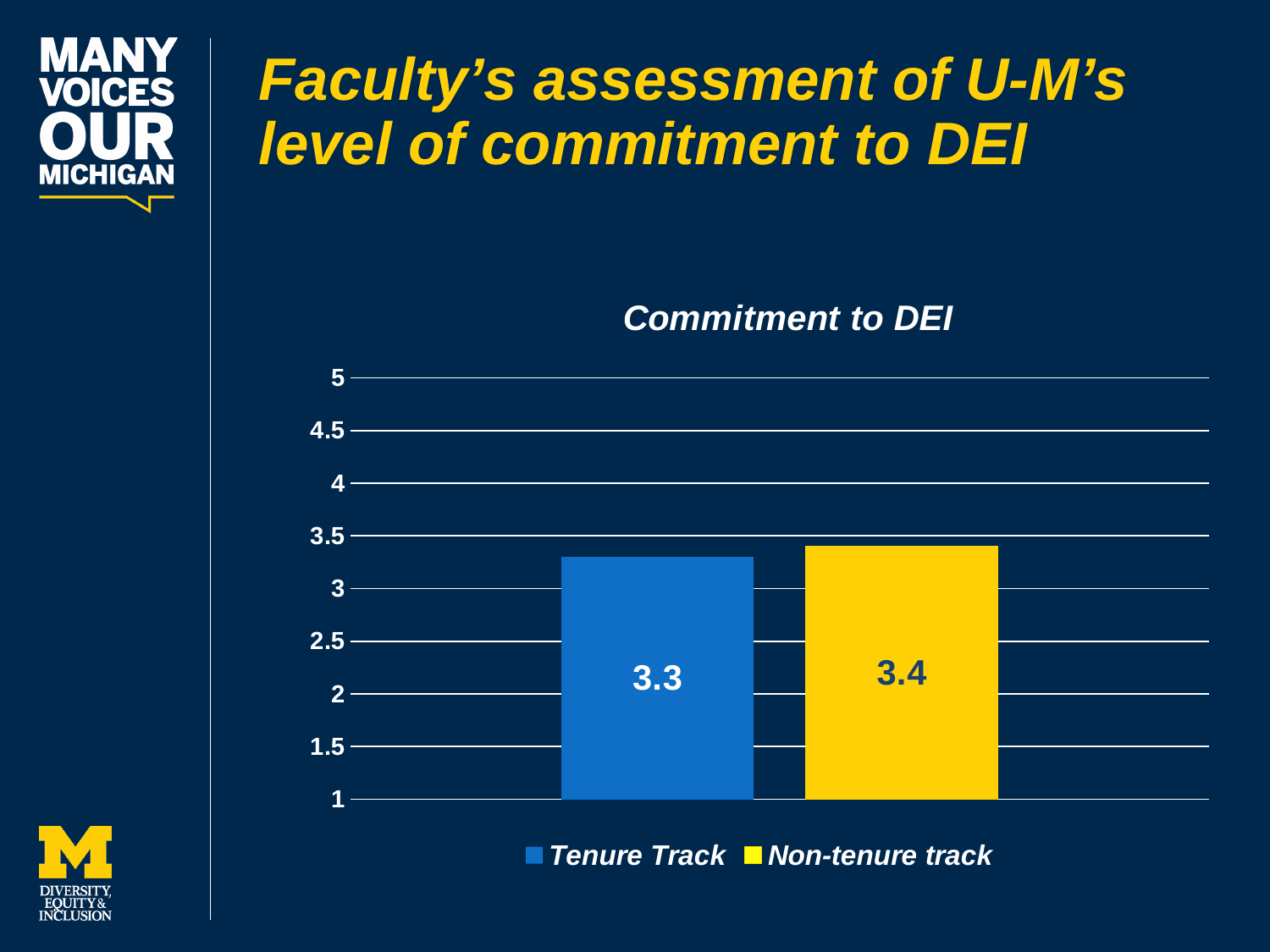
What is the title of the chart? Commitment to DEI How many bars are plotted in the Commitment to DEI chart? 2 Which group has the higher value in the Commitment to DEI chart? Non-tenure track What is the value for Tenure Track in the Commitment to DEI chart? 3.3 What kind of chart is shown on the slide? bar chart Is the value for Tenure Track larger or smaller than the value for Non-tenure track? smaller Is the value for Non-tenure track greater or less than 3.5? less How many series does the legend list? 2 What is the difference between the Non-tenure track and Tenure Track values? 0.1 What is the value for Non-tenure track in the Commitment to DEI chart? 3.4 Which group has the lower value in the Commitment to DEI chart? Tenure Track Is the value for Tenure Track greater or less than 3? greater